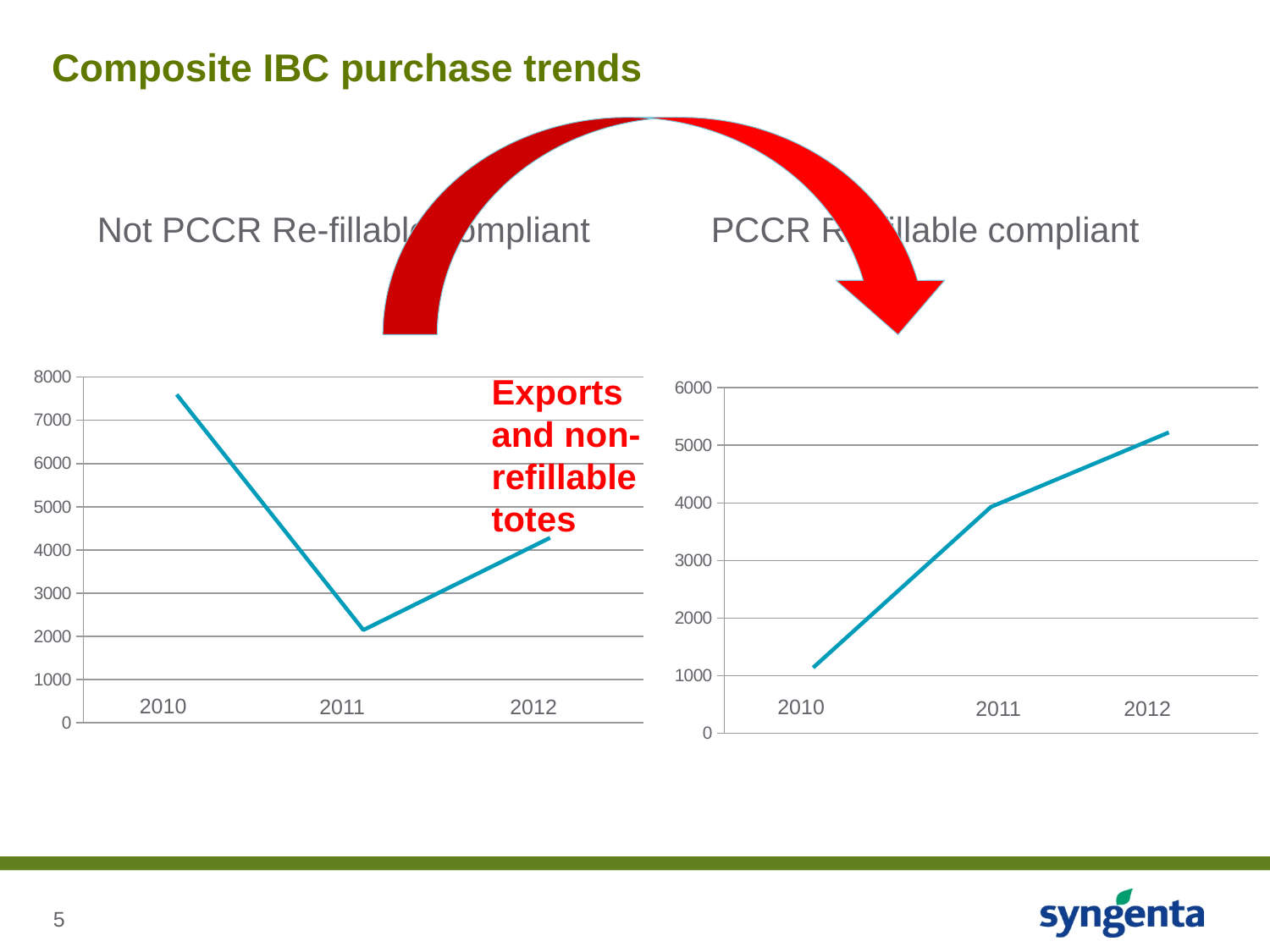
In the right chart (PCCR Re-fillable compliant), do the values rise or fall from 2010 to 2012? rise How many years are plotted on the left chart (Not PCCR Re-fillable compliant)? 3 In the left chart (Not PCCR Re-fillable compliant), which year has the lowest value? 2011 In the right chart (PCCR Re-fillable compliant), is the value for 2012 greater or less than 5000? greater What kind of chart is the right chart (PCCR Re-fillable compliant)? line chart In the right chart (PCCR Re-fillable compliant), which year has the lowest value? 2010 What kind of chart is the left chart (Not PCCR Re-fillable compliant)? line chart In the right chart (PCCR Re-fillable compliant), is the value for 2010 greater or less than 2000? less In the right chart (PCCR Re-fillable compliant), which year has the highest value? 2012 In the left chart (Not PCCR Re-fillable compliant), which year has the highest value? 2010 In the left chart (Not PCCR Re-fillable compliant), is the value for 2010 greater or less than 7000? greater